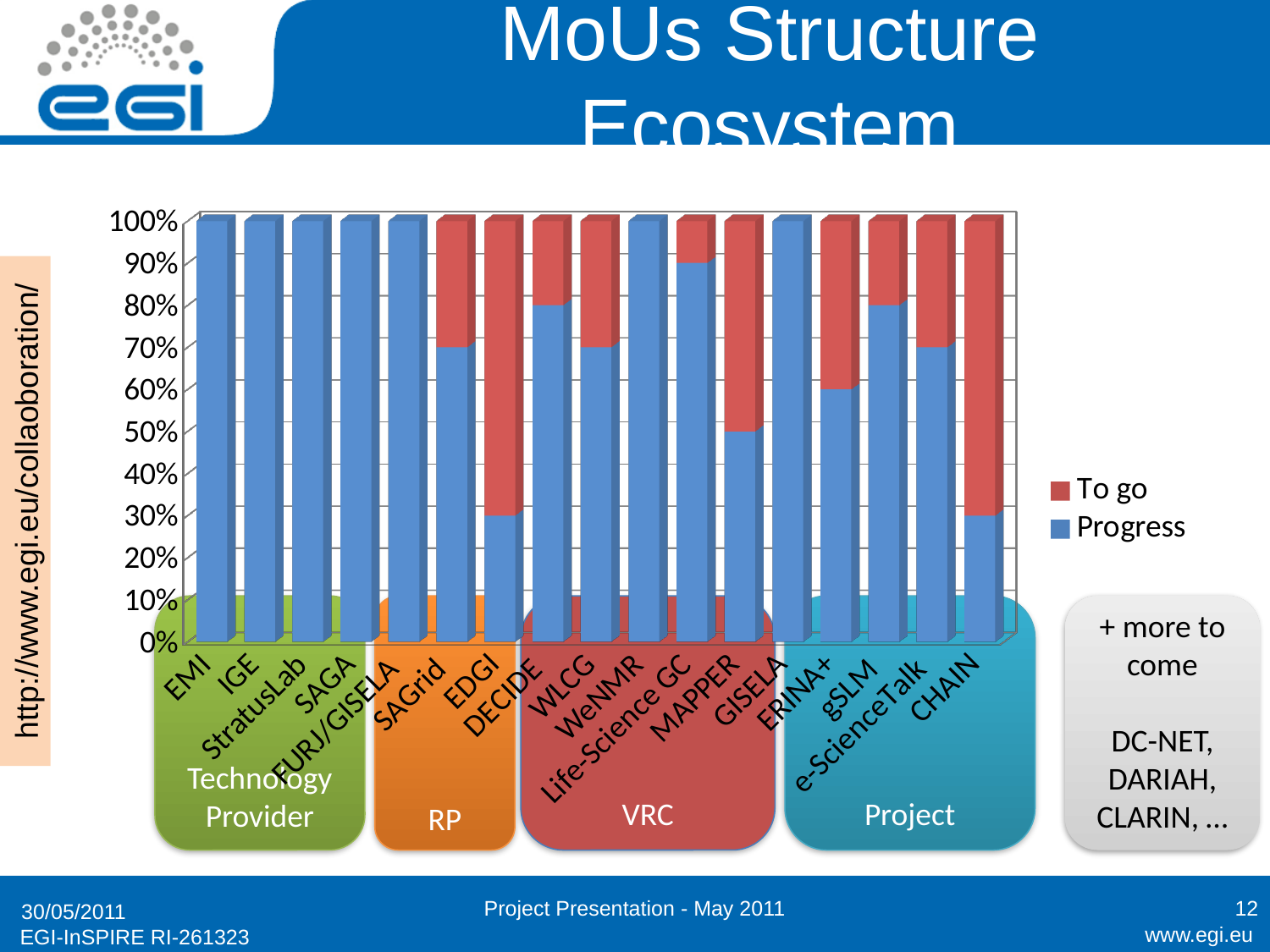
How many series does the legend list? 2 What kind of chart is shown on the slide? stacked bar chart Which has a larger Progress value, CHAIN or gSLM? gSLM Is the Progress value for ERINA+ greater or less than 80%? less Is the Progress value for Life-Science GC greater or less than 80%? greater Which has a larger Progress value, EDGI or MAPPER? MAPPER What is the Progress value for EMI? 100% Is the Progress value for EDGI greater or less than 50%? less What is the Progress value for WeNMR? 100% What are the two series named in the legend? To go, Progress How many categories (MoUs) are plotted along the x axis? 17 What colour represents the Progress series? blue